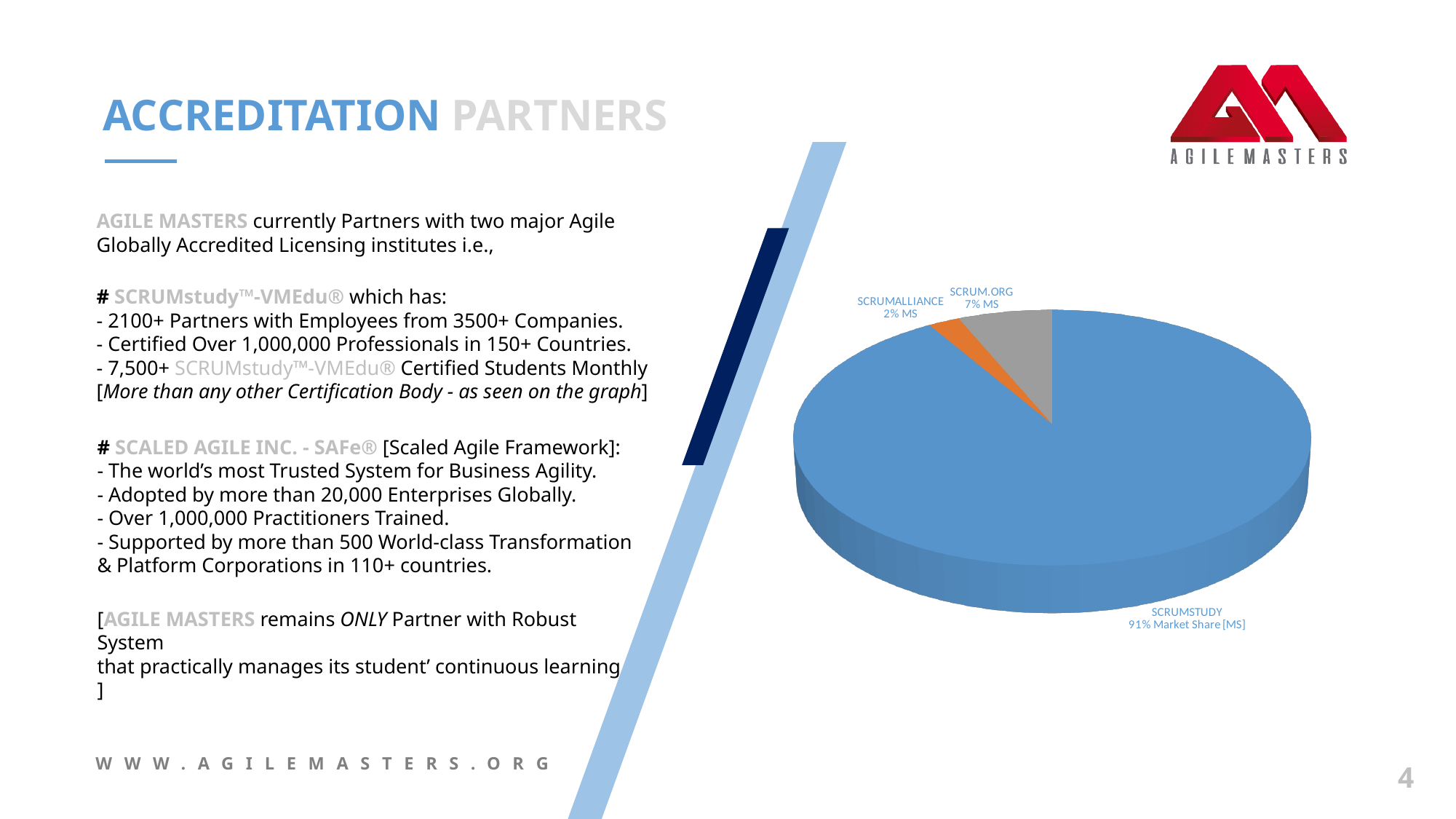
Which slice of the pie chart is the smallest? SCRUMALLIANCE Which slice of the pie chart is the largest? SCRUMSTUDY What is the difference in market share between SCRUM.ORG and SCRUMALLIANCE? 5% What market share does the SCRUM.ORG slice show? 7% How many slices does the pie chart have? 3 What market share does the SCRUMSTUDY slice show? 91% What colour is the SCRUMALLIANCE slice in the pie chart? orange Which has a larger market share, SCRUM.ORG or SCRUMALLIANCE? SCRUM.ORG What colour is the SCRUMSTUDY slice in the pie chart? blue What market share does the SCRUMALLIANCE slice show? 2% What is the difference in market share between SCRUMSTUDY and SCRUM.ORG? 84% What kind of chart is shown on the slide? pie chart